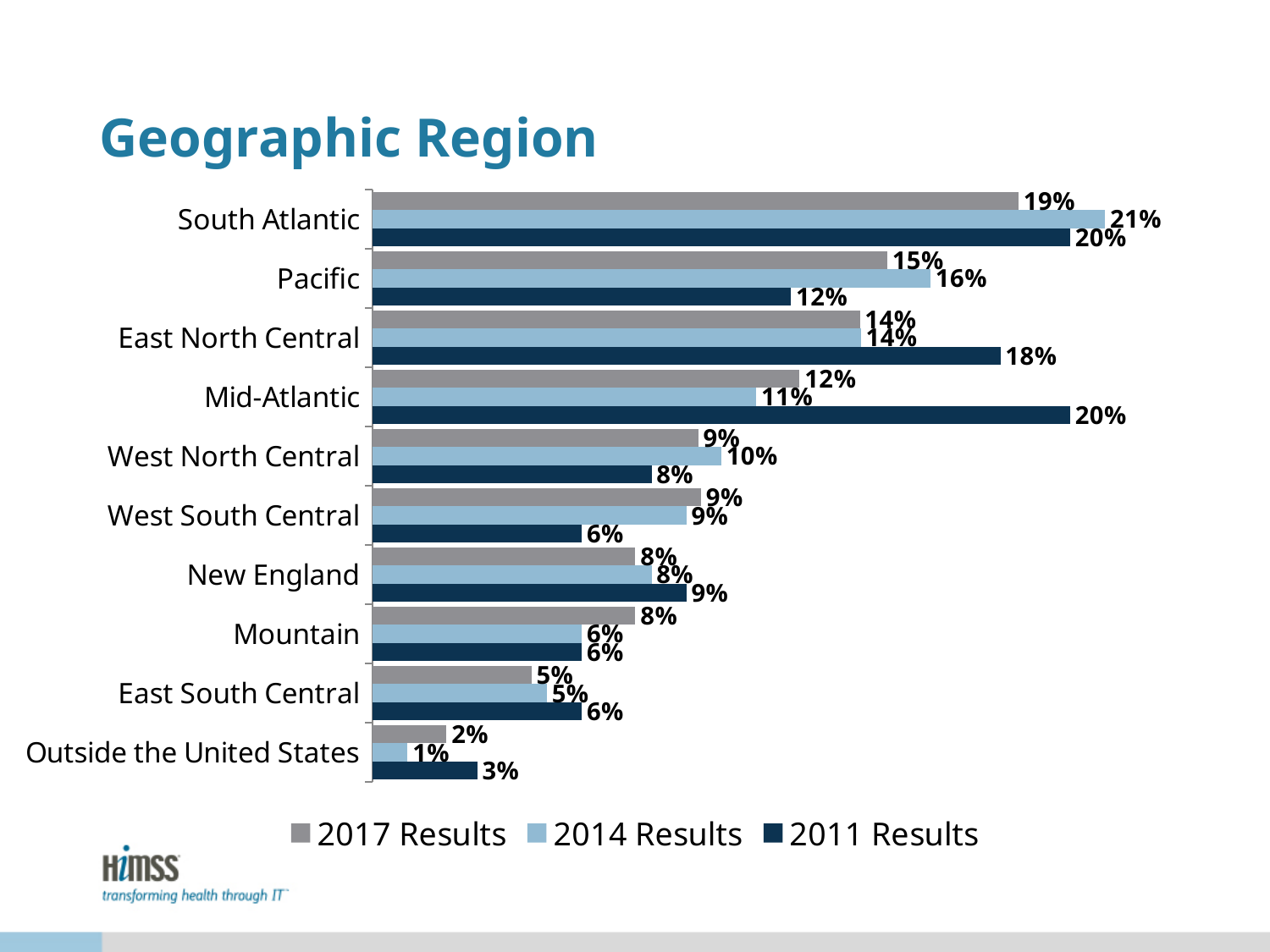
What is the difference between the 2014 Results and 2011 Results values for Pacific? 4% Which region has the highest 2014 Results value? South Atlantic What is the 2014 Results value for Pacific? 16% What is the title of the slide? Geographic Region Which region has the lowest 2017 Results value? Outside the United States What kind of chart is shown on the slide? Bar chart What is the difference between the 2011 Results and 2017 Results values for Mid-Atlantic? 8% Which is larger for East North Central: the 2011 Results value or the 2017 Results value? 2011 Results How many geographic regions are shown on the chart? 10 What is the 2011 Results value for Mid-Atlantic? 20% How many series does the legend list? 3 What is the 2017 Results value for South Atlantic? 19%